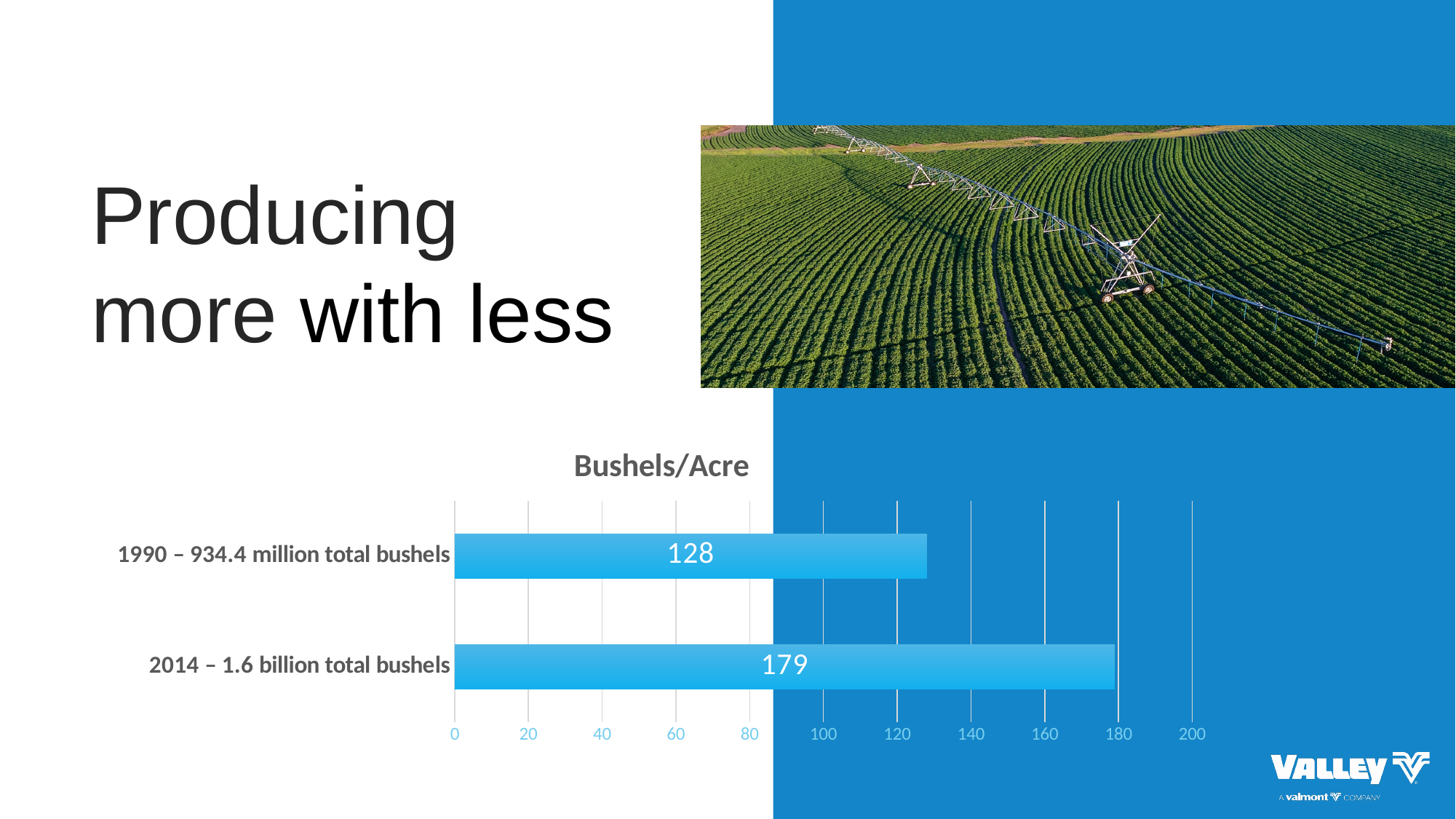
Which category has the lowest value in the Bushels/Acre chart? 1990 – 934.4 million total bushels Which category has the highest value in the Bushels/Acre chart? 2014 – 1.6 billion total bushels What kind of chart is shown on the slide? Bar chart What is the value for 1990 – 934.4 million total bushels in the Bushels/Acre chart? 128 Which is larger in the Bushels/Acre chart: the value for 1990 or the value for 2014? 2014 What is the difference between the 2014 and 1990 values in the Bushels/Acre chart? 51 What is the value for 2014 – 1.6 billion total bushels in the Bushels/Acre chart? 179 What is the maximum value shown on the x axis of the Bushels/Acre chart? 200 Is the value for 2014 – 1.6 billion total bushels greater or less than 160? greater How many categories are shown in the Bushels/Acre chart? 2 Is the value for 1990 – 934.4 million total bushels greater or less than 140? less What is the title of the chart on the slide? Bushels/Acre